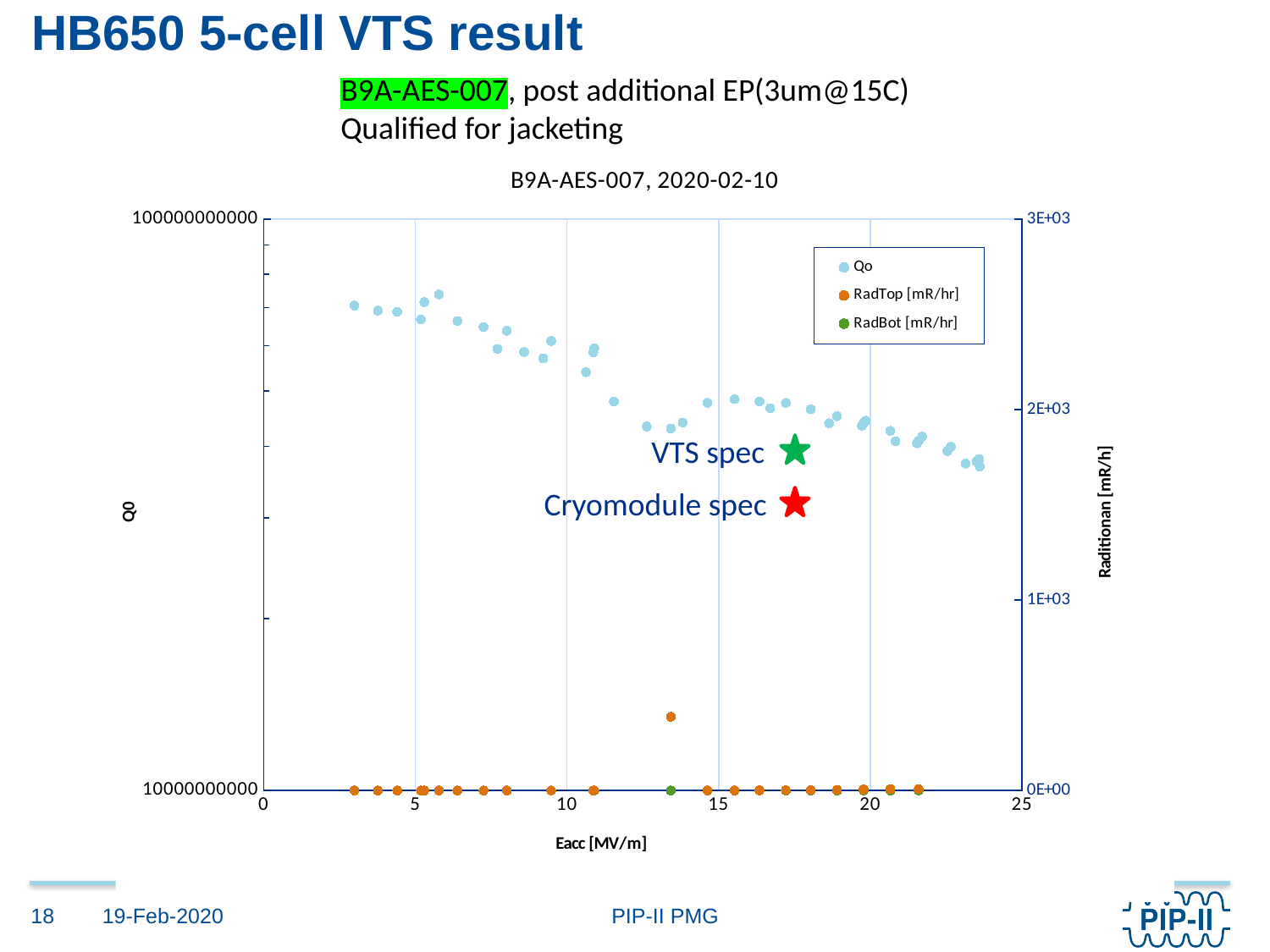
What kind of chart is shown on the slide? scatter chart Are the Qo values at Eacc around 5 MV/m greater or less than 10000000000 on the left axis? greater How many series does the chart legend list? 3 What is the title of the chart? B9A-AES-007, 2020-02-10 Which series has more plotted points, Qo or RadBot [mR/hr]? Qo Do the Qo values rise or fall as Eacc increases along the x axis? fall Is the highest RadTop [mR/hr] value on the chart greater or less than 1E+03 on the right axis? less What is the maximum value shown on the right-hand axis of the chart? 3E+03 What is the maximum value shown on the x axis of the chart? 25 Which series is plotted at a higher position on the chart, Qo or RadTop [mR/hr]? Qo What is the label of the x axis of the chart? Eacc [MV/m]